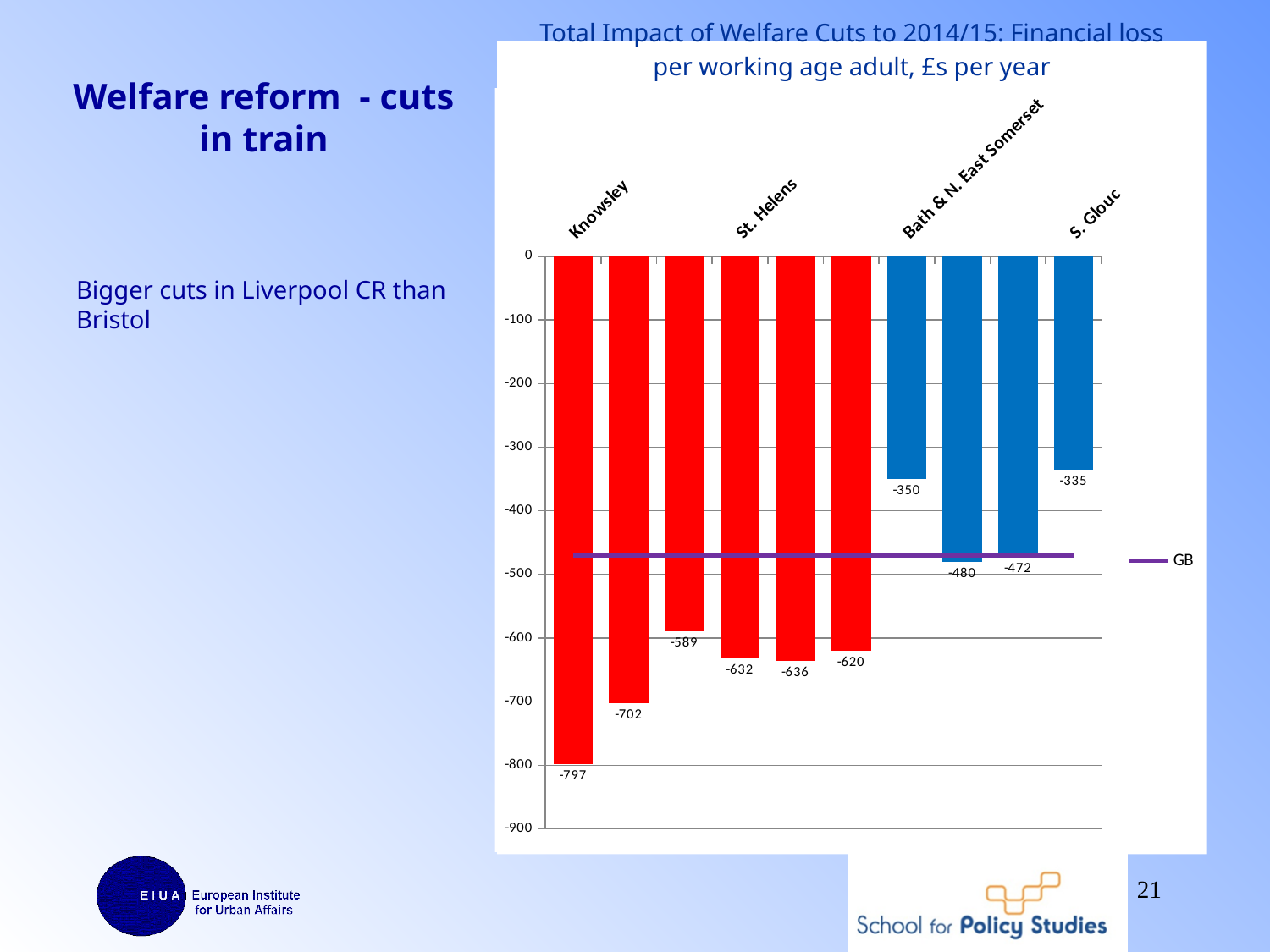
Which labelled area has the smallest financial loss per working age adult? S. Glouc How many bars are plotted in the chart? 10 What is the value for St. Helens? -632 What is the value for S. Glouc? -335 What is the value for Knowsley? -797 What is the value for Bath & N. East Somerset? -350 What is the name of the series shown as a horizontal line in the legend? GB Which labelled area has the largest financial loss per working age adult? Knowsley What kind of chart is shown on the slide? Bar chart Which has the larger financial loss, Knowsley or St. Helens? Knowsley What is the difference between the values for Knowsley and S. Glouc? 462 What is the title of the chart? Total Impact of Welfare Cuts to 2014/15: Financial loss per working age adult, £s per year